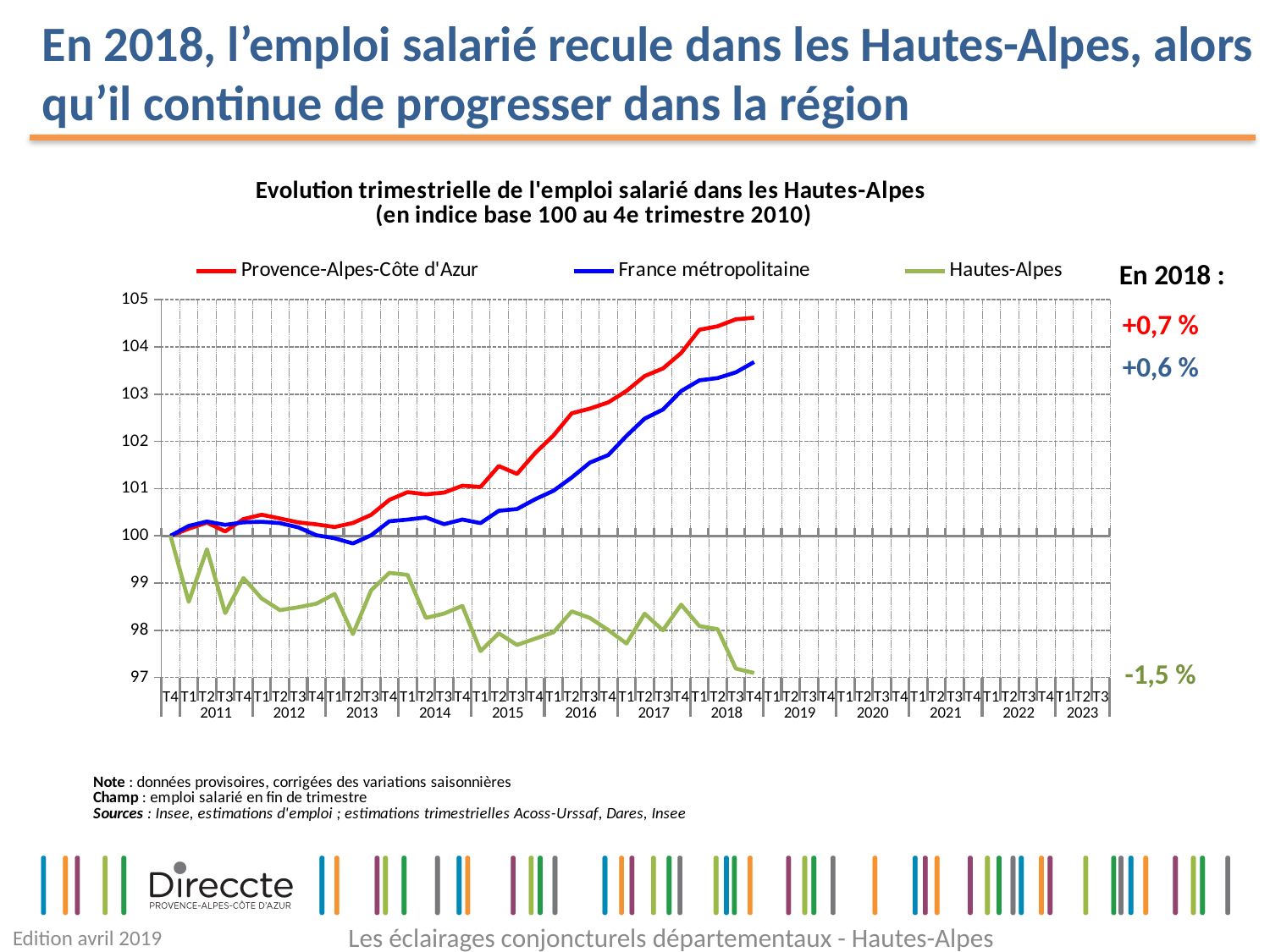
Is the value for France métropolitaine at T4 2018 greater or less than 104? less Which three series are listed in the chart legend? Provence-Alpes-Côte d'Azur, France métropolitaine, Hautes-Alpes What is the title of the chart? Evolution trimestrielle de l'emploi salarié dans les Hautes-Alpes (en indice base 100 au 4e trimestre 2010) How many series does the chart legend list? 3 According to the annotation on the right of the chart, what was the change in 2018 for France métropolitaine? +0,6 % At T4 2018, which series has the higher value: Provence-Alpes-Côte d'Azur or France métropolitaine? Provence-Alpes-Côte d'Azur Is the value for Hautes-Alpes at T4 2018 greater or less than 98? less Does the Hautes-Alpes line overall rise or fall between T4 2010 and T4 2018? fall According to the annotation on the right of the chart, what was the change in 2018 for Hautes-Alpes? -1,5 % According to the annotation on the right of the chart, what was the change in 2018 for Provence-Alpes-Côte d'Azur? +0,7 % Is the value for Provence-Alpes-Côte d'Azur at T4 2018 greater or less than 104? greater What type of chart is shown on the slide? line chart